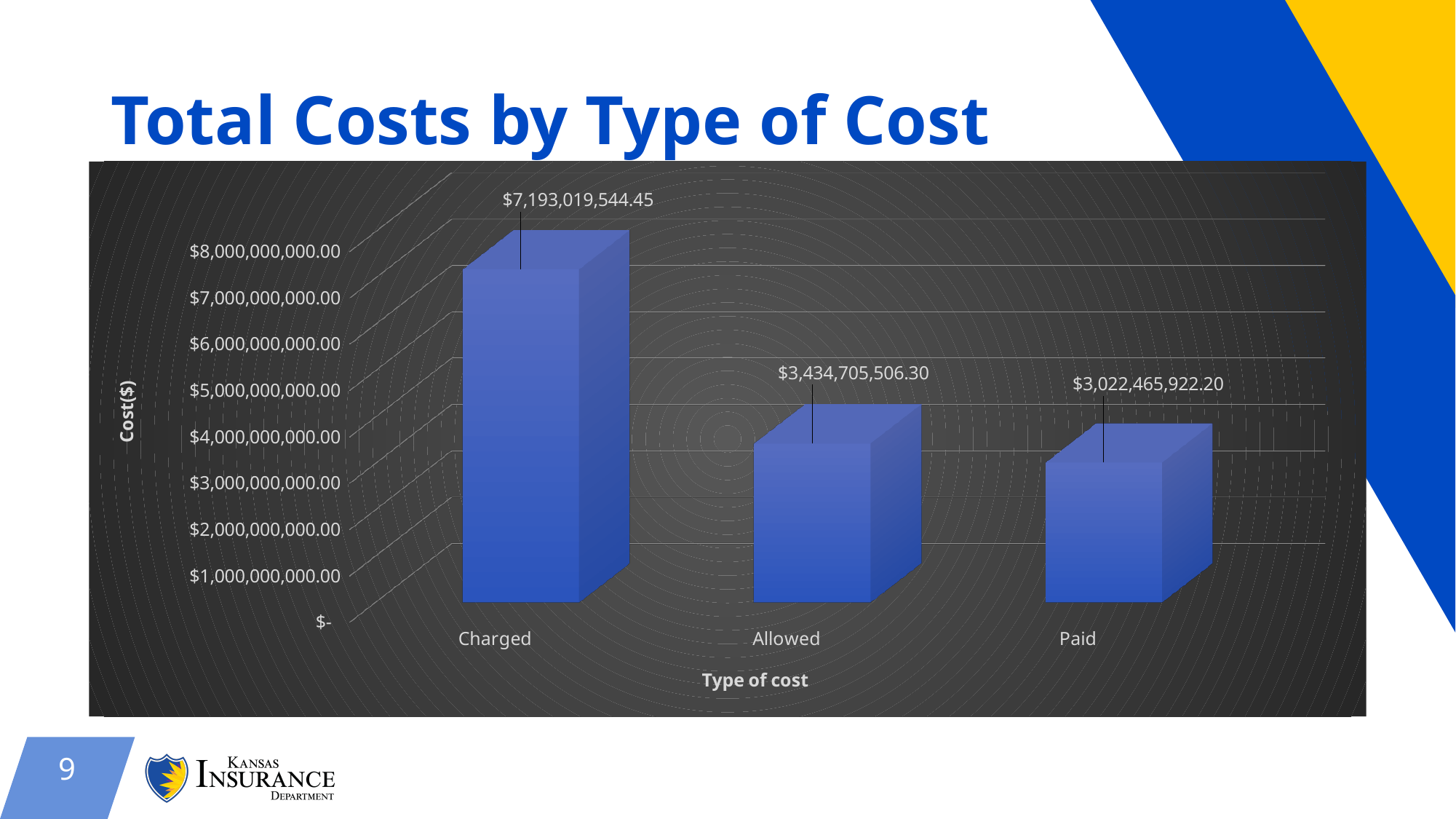
Which is larger, the value for Allowed or the value for Paid? Allowed What is the difference between the Charged and Allowed values? $3,758,314,038.15 What is the difference between the Allowed and Paid values? $412,239,584.10 Is the value for Paid greater or less than $4,000,000,000.00? less What kind of chart is shown on the slide? Bar chart What is the label of the vertical axis? Cost($) What is the value for Charged? $7,193,019,544.45 Which type of cost has the lowest total? Paid What is the value for Allowed? $3,434,705,506.30 Which type of cost has the highest total? Charged How many types of cost are shown on the chart? 3 What is the value for Paid? $3,022,465,922.20